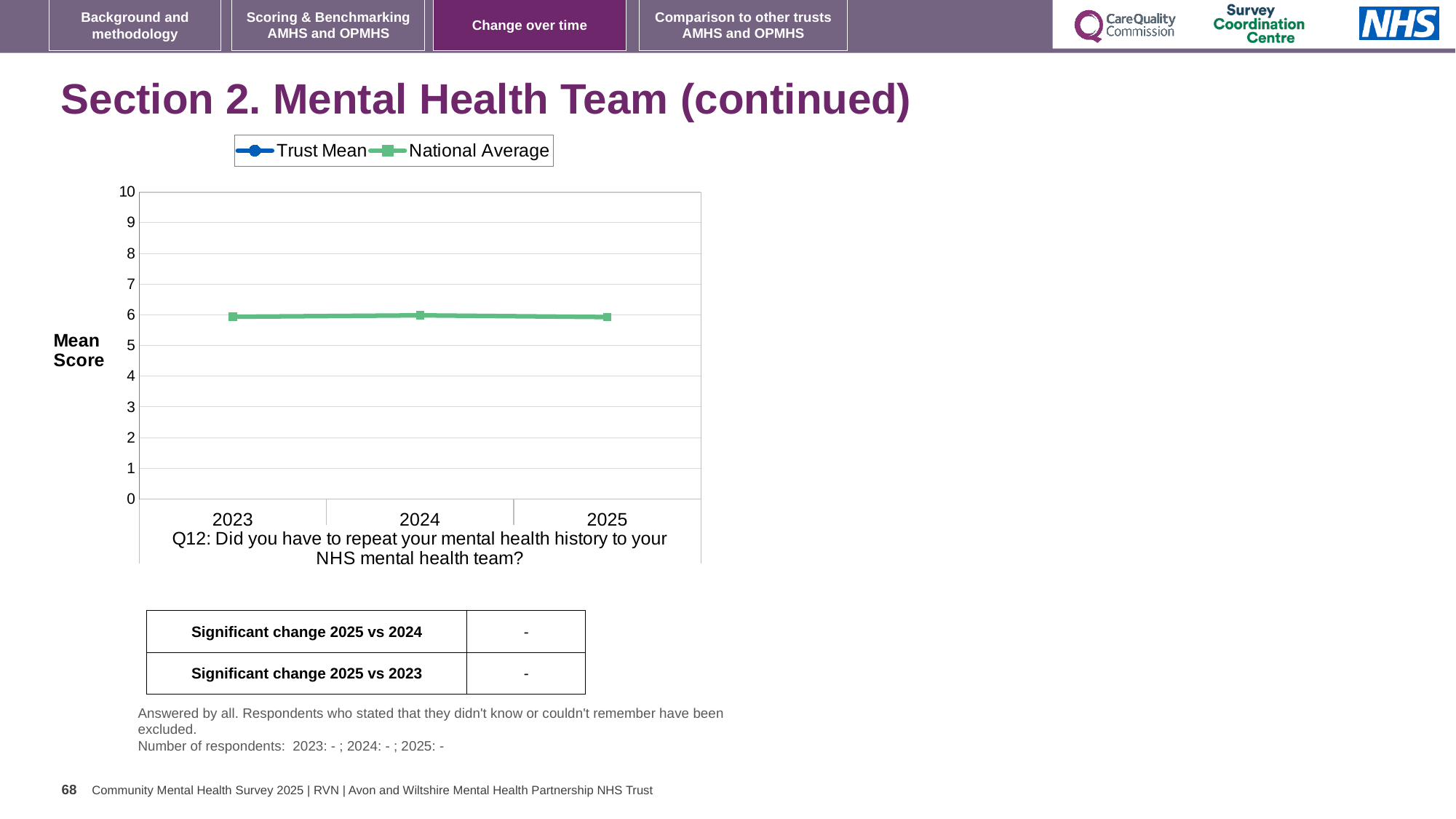
Is the National Average value for 2023 greater or less than 5? greater What is the label on the vertical axis of the chart? Mean Score What is the maximum value shown on the chart's vertical axis? 10 What kind of chart is shown on the slide? line chart What is the last year shown on the x axis of the chart? 2025 Is the National Average value for 2025 greater or less than 8? less How many years are shown on the x axis of the chart? 3 How many series does the chart legend list? 2 Is the National Average value for 2025 greater or less than 4? greater What are the two series named in the chart legend? Trust Mean and National Average What is the first year shown on the x axis of the chart? 2023